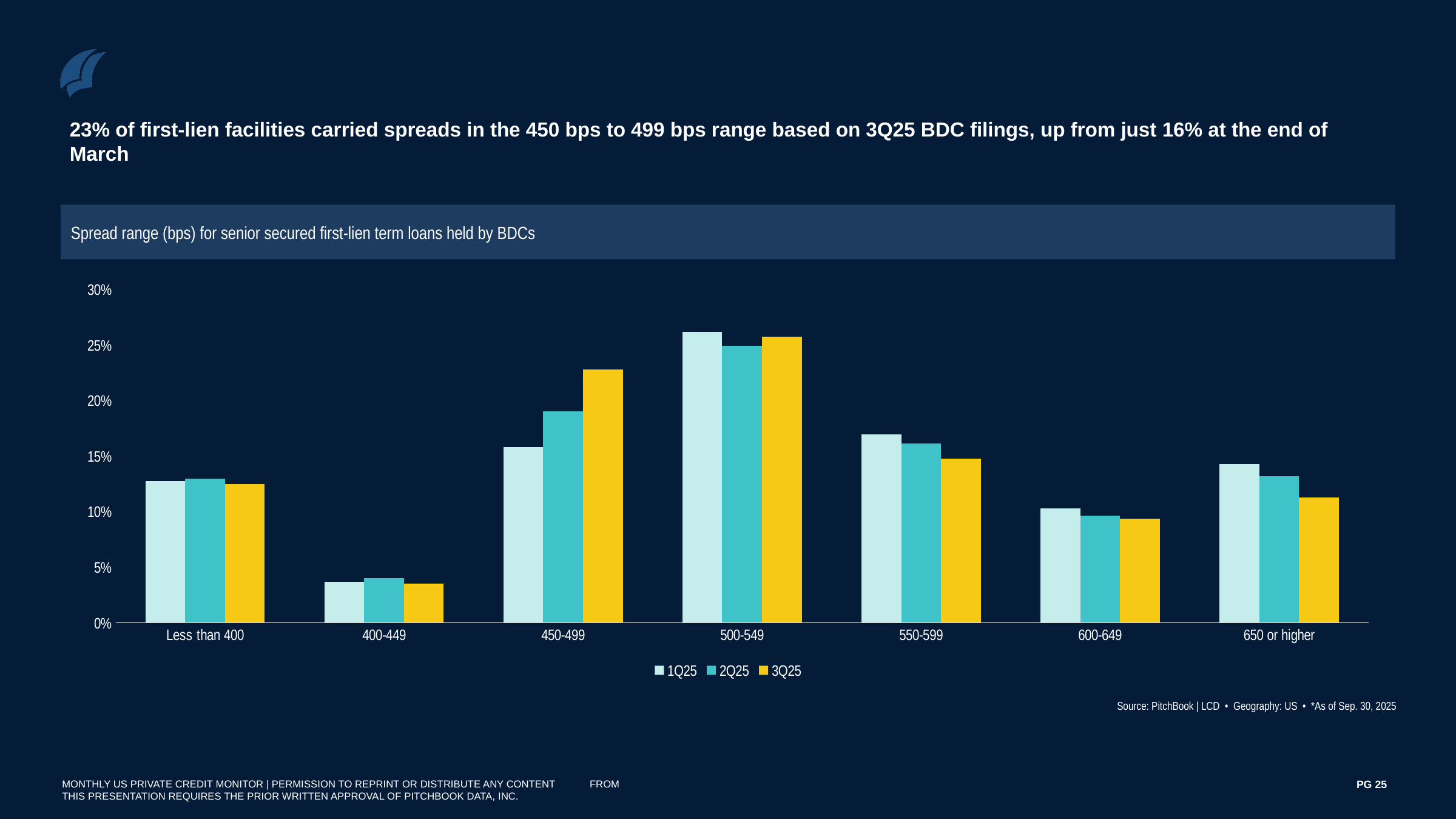
How many spread range categories are shown on the x axis? 7 How many series does the legend list? 3 For the 650 or higher range, which is larger: the 1Q25 value or the 3Q25 value? 1Q25 Is the 2Q25 value for the 400-449 range greater or less than 5%? less Which spread range has the lowest 1Q25 value? 400-449 Is the 1Q25 value for the 550-599 range greater or less than 15%? greater What kind of chart is shown on the slide? Bar chart Moving from the 500-549 range to the 650 or higher range, do the 3Q25 values rise or fall? fall Is the 3Q25 value for the 450-499 range greater or less than 20%? greater Which spread range has the highest 3Q25 value? 500-549 For the 450-499 range, which is larger: the 2Q25 value or the 3Q25 value? 3Q25 What is the title of the chart? Spread range (bps) for senior secured first-lien term loans held by BDCs